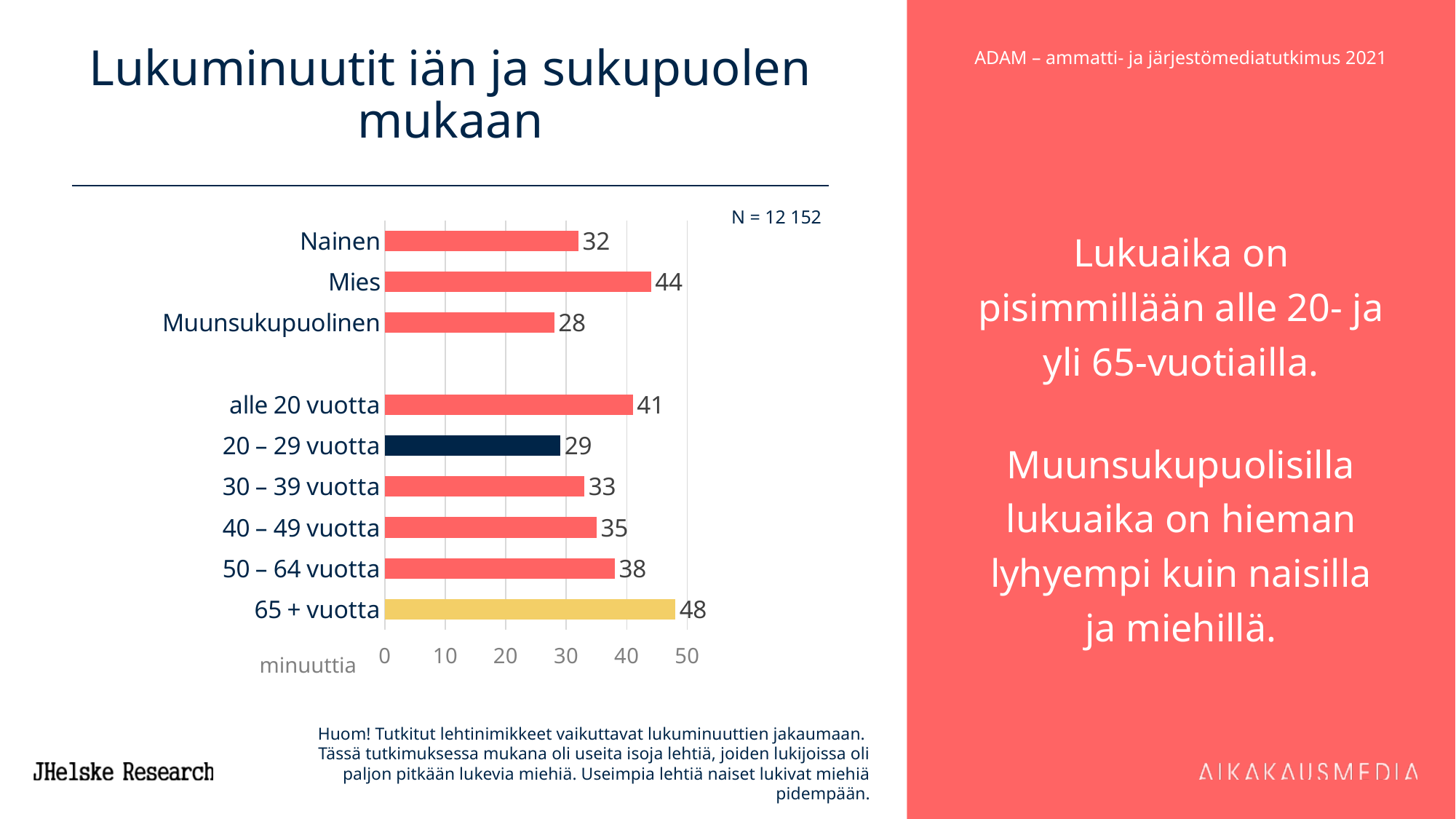
What is the title of the chart? Lukuminuutit iän ja sukupuolen mukaan How many categories are shown in the chart? 9 What is the value for Mies? 44 Is the value for 20 – 29 vuotta greater or less than 30? less Which is larger, the value for alle 20 vuotta or the value for 50 – 64 vuotta? alle 20 vuotta What is the value for 65 + vuotta? 48 What kind of chart is shown on the slide? bar chart What is the difference between the values for Mies and Nainen? 12 What is the value for Muunsukupuolinen? 28 Which category has the highest value? 65 + vuotta What unit is shown on the x axis of the chart? minuuttia Which category has the lowest value? Muunsukupuolinen